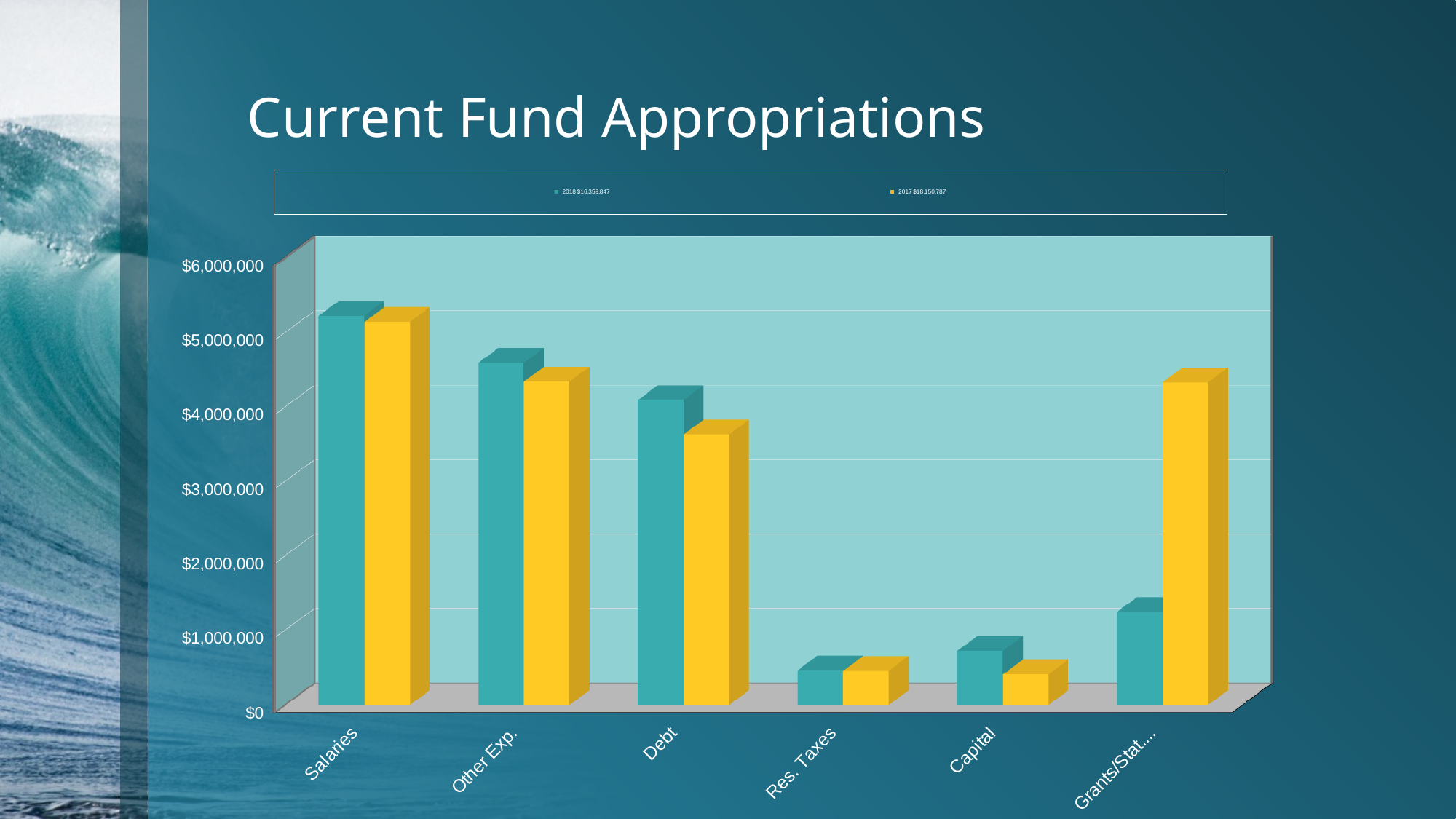
Is the 2017 value for Debt greater or less than $4,000,000? less What kind of chart is shown on the slide? bar chart What is the title of the slide containing the chart? Current Fund Appropriations Which category has the highest 2018 value? Salaries What total is shown in the legend entry for the 2018 series? $16,359,847 How many series does the chart's legend list? 2 Is the 2018 value for Salaries greater or less than $5,000,000? greater Is the 2018 value for Grants/Stat.... greater or less than $2,000,000? less For Grants/Stat...., which series has the larger value, 2018 or 2017? 2017 Which category has the lowest 2017 value? Capital How many categories are shown on the x axis of the chart? 6